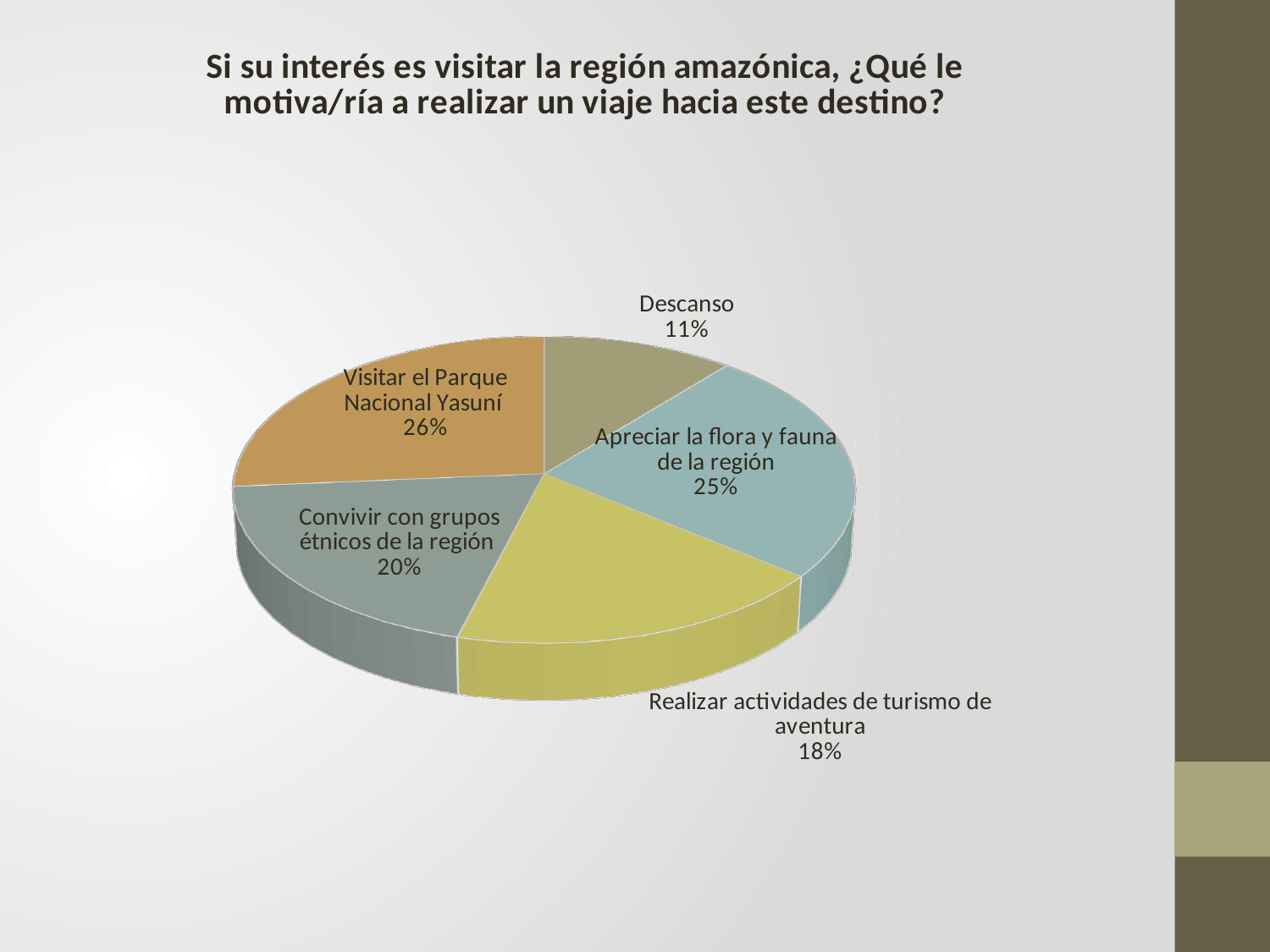
What share is shown for "Visitar el Parque Nacional Yasuní"? 26% Which motivation has the largest share of the pie? Visitar el Parque Nacional Yasuní What percentage is shown for "Realizar actividades de turismo de aventura"? 18% What percentage is shown for "Apreciar la flora y fauna de la región"? 25% Which has a larger share: "Convivir con grupos étnicos de la región" or "Realizar actividades de turismo de aventura"? Convivir con grupos étnicos de la región Which motivation has the smallest share of the pie? Descanso What is the combined share of "Visitar el Parque Nacional Yasuní" and "Apreciar la flora y fauna de la región"? 51% What kind of chart is shown on the slide? Pie chart How many slices does the pie chart have? 5 What is the difference in percentage points between "Convivir con grupos étnicos de la región" and "Descanso"? 9 What colour is the slice for "Visitar el Parque Nacional Yasuní"? Orange What percentage of respondents chose "Descanso" as their motivation? 11%